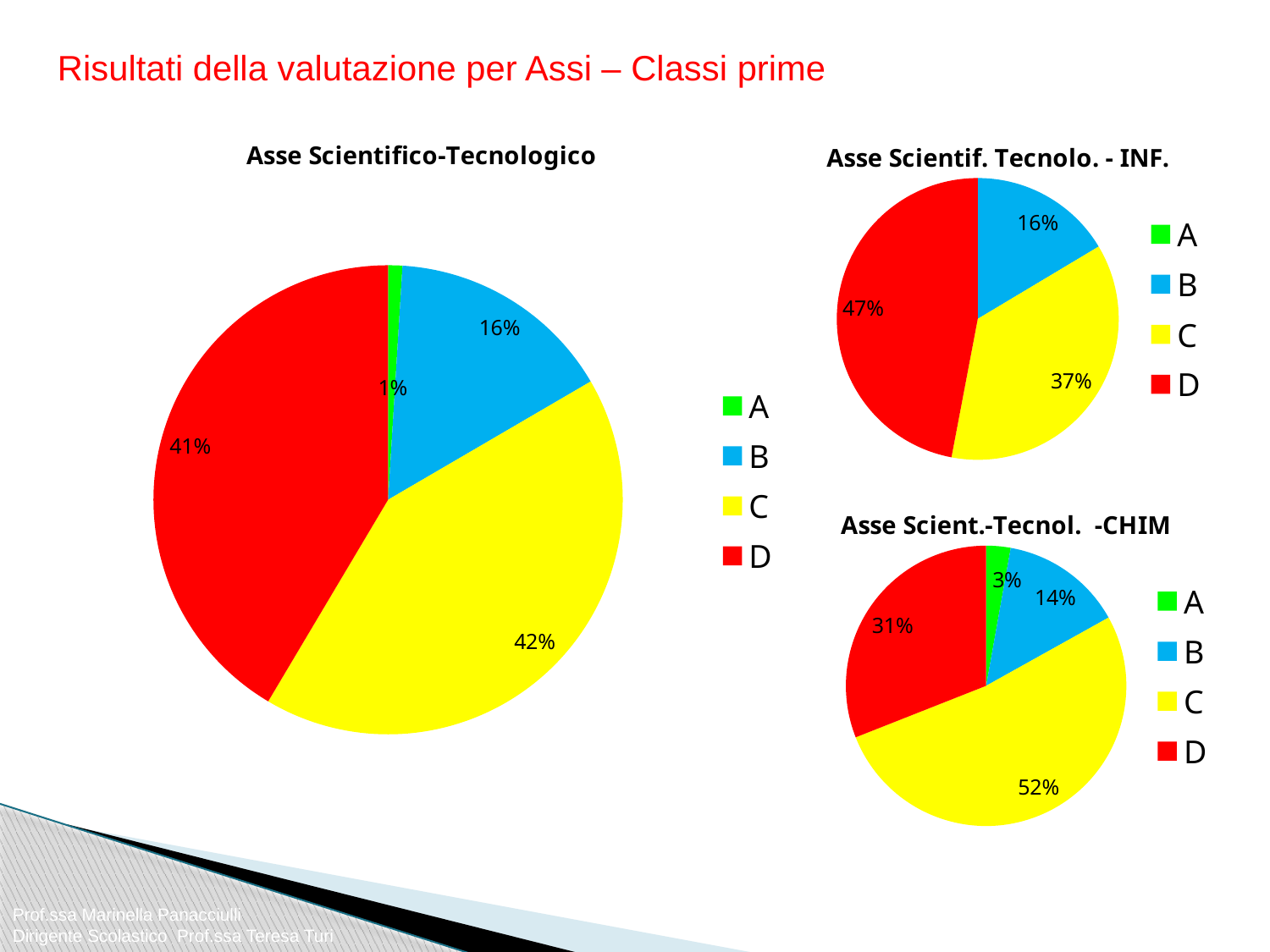
In the chart titled "Asse Scientif. Tecnolo. - INF.", which category has the largest slice? D In the chart titled "Asse Scient.-Tecnol. -CHIM", which category has the largest slice? C In the chart titled "Asse Scient.-Tecnol. -CHIM", what is the difference between the percentages for C and D? 21% In the chart titled "Asse Scientifico-Tecnologico", what percentage is shown for category C? 42% In the chart titled "Asse Scient.-Tecnol. -CHIM", what percentage is shown for category A? 3% What type of chart is the chart titled "Asse Scientifico-Tecnologico"? Pie chart In the chart titled "Asse Scientifico-Tecnologico", what is the difference between the percentages for D and B? 25% In the chart titled "Asse Scientif. Tecnolo. - INF.", which is larger, the slice for B or the slice for C? C In the chart titled "Asse Scientif. Tecnolo. - INF.", what percentage is shown for category D? 47% In the chart titled "Asse Scientifico-Tecnologico", which category has the smallest slice? A In the chart titled "Asse Scientifico-Tecnologico", what colour is the slice for category D? Red How many entries does the legend of the chart titled "Asse Scient.-Tecnol. -CHIM" list? 4